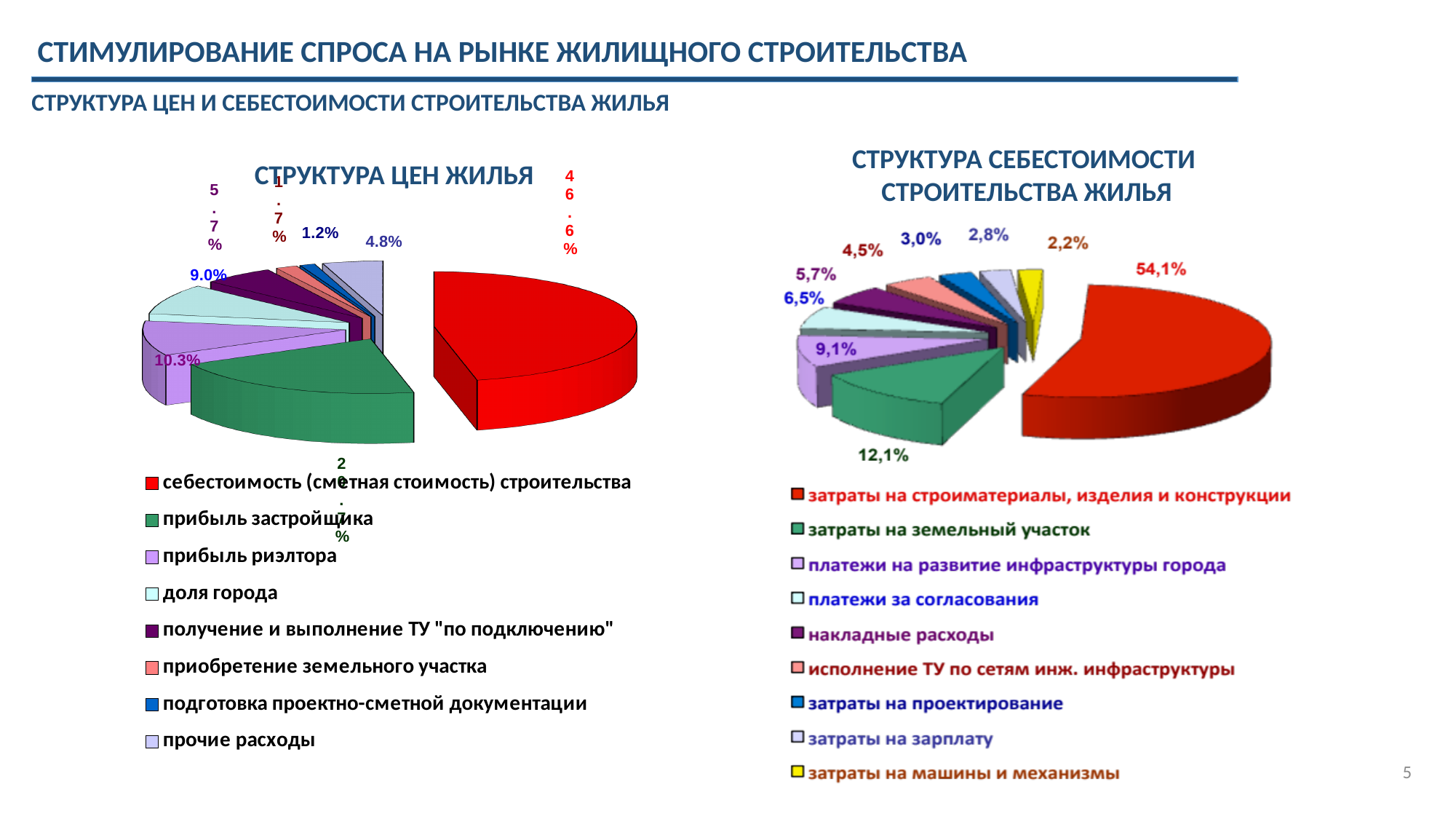
In the chart titled «СТРУКТУРА СЕБЕСТОИМОСТИ СТРОИТЕЛЬСТВА ЖИЛЬЯ», what is the difference between the shares for «затраты на земельный участок» and «платежи на развитие инфраструктуры города»? 3,0% In the chart titled «СТРУКТУРА ЦЕН ЖИЛЬЯ», which category has the smallest share? подготовка проектно-сметной документации In the chart titled «СТРУКТУРА СЕБЕСТОИМОСТИ СТРОИТЕЛЬСТВА ЖИЛЬЯ», which is larger: «платежи за согласования» or «накладные расходы»? платежи за согласования In the chart titled «СТРУКТУРА ЦЕН ЖИЛЬЯ», what share is shown for «себестоимость (сметная стоимость) строительства»? 46.6% In the chart titled «СТРУКТУРА ЦЕН ЖИЛЬЯ», what share is shown for «прибыль риэлтора»? 10.3% In the chart titled «СТРУКТУРА СЕБЕСТОИМОСТИ СТРОИТЕЛЬСТВА ЖИЛЬЯ», what share is shown for «затраты на земельный участок»? 12,1% In the chart titled «СТРУКТУРА ЦЕН ЖИЛЬЯ», what share is shown for «доля города»? 9.0% In the chart titled «СТРУКТУРА СЕБЕСТОИМОСТИ СТРОИТЕЛЬСТВА ЖИЛЬЯ», how many categories does the legend list? 9 In the chart titled «СТРУКТУРА ЦЕН ЖИЛЬЯ», how many categories does the legend list? 8 In the chart titled «СТРУКТУРА СЕБЕСТОИМОСТИ СТРОИТЕЛЬСТВА ЖИЛЬЯ», which category has the smallest share? затраты на машины и механизмы In the chart titled «СТРУКТУРА СЕБЕСТОИМОСТИ СТРОИТЕЛЬСТВА ЖИЛЬЯ», what share is shown for «затраты на строиматериалы, изделия и конструкции»? 54,1% What type of chart is «СТРУКТУРА ЦЕН ЖИЛЬЯ»? pie chart